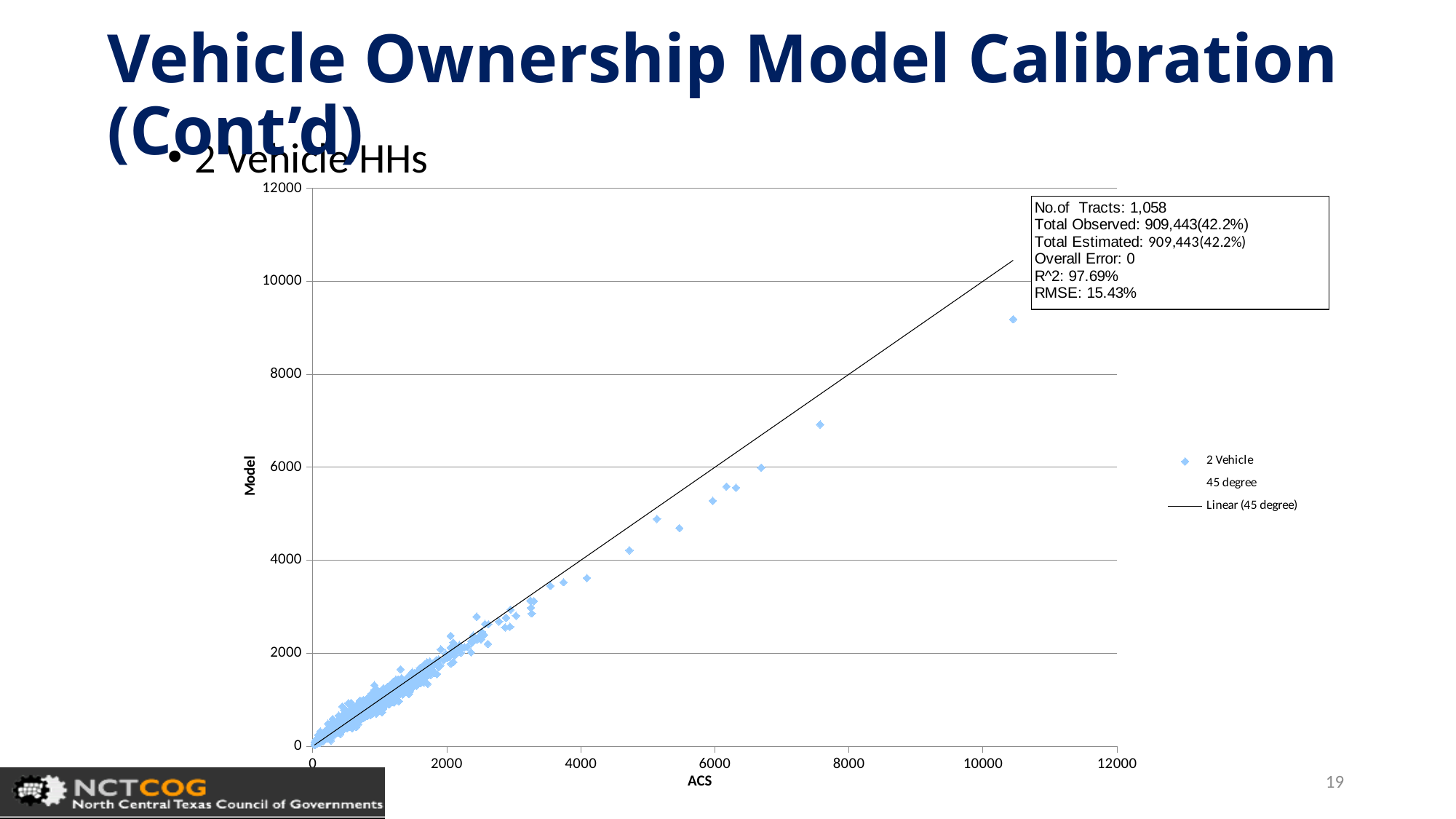
Is the Model value of the highest plotted point greater or less than 8000? greater What Total Observed value is reported in the chart's text box? 909,443(42.2%) Do the Model values generally rise or fall as ACS values increase along the x axis? rise Is the Model value of the highest plotted point greater or less than 10000? less What is the label of the y axis? Model What RMSE value is reported in the chart's text box? 15.43% What kind of chart is shown on the slide? scatter chart How many entries does the chart legend list? 3 According to the text box on the chart, how many tracts are plotted? 1,058 What R^2 value is reported in the chart's text box? 97.69% What is the label of the x axis? ACS What Overall Error is reported in the chart's text box? 0